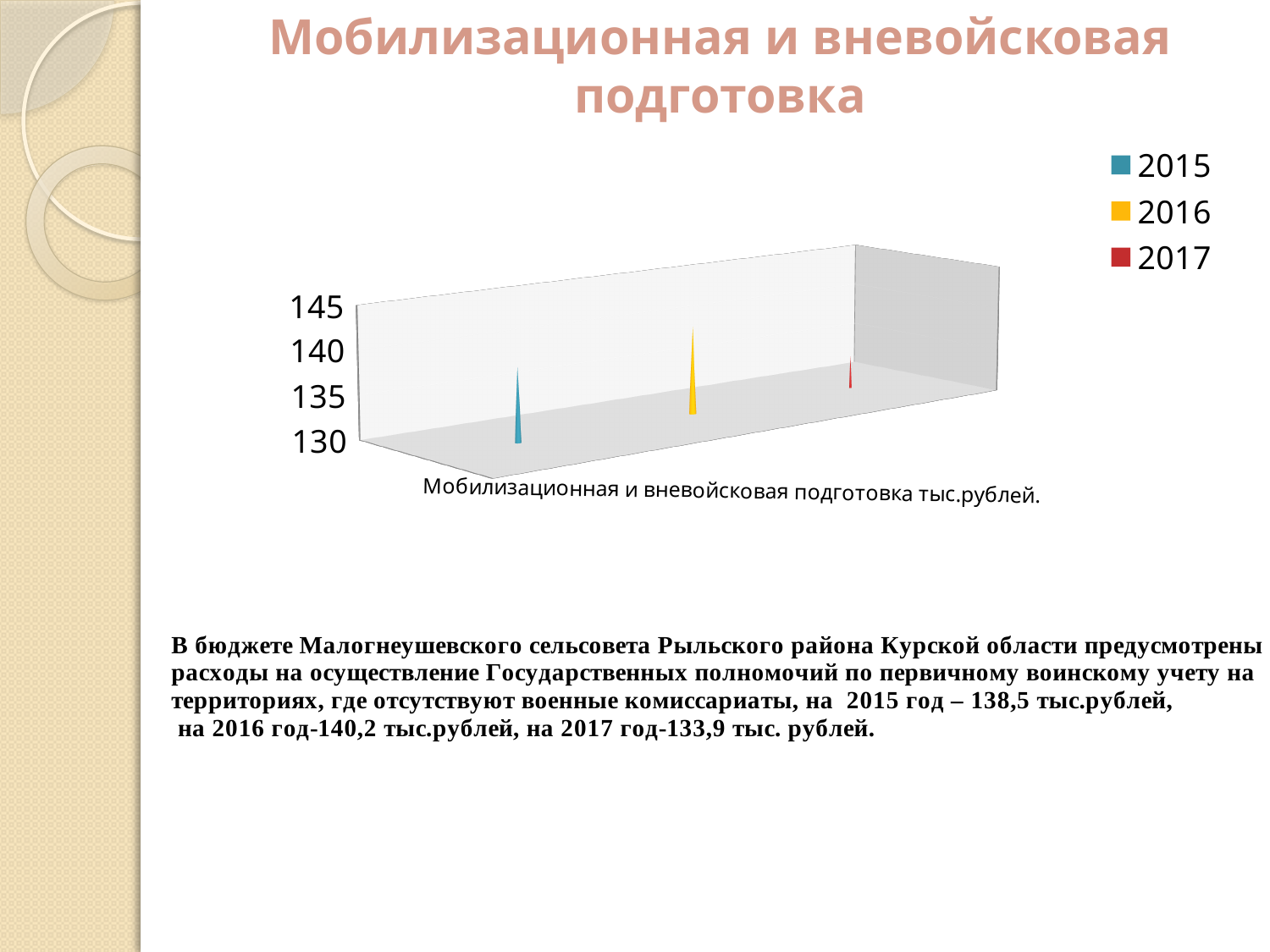
Which is larger, the value for 2015 or the value for 2017? 2015 According to the slide text, what is the amount for 2017 in thousand rubles? 133,9 Do the values rise or fall from 2016 to 2017? fall Is the value for 2017 greater or less than 135? less Is the value for 2015 greater or less than 135? greater Is the value for 2016 greater or less than 135? greater Which years are listed in the chart legend? 2015, 2016, 2017 How many series does the chart legend list? 3 According to the slide text, what is the amount for 2015 in thousand rubles? 138,5 What kind of chart is shown on the slide? bar chart Which year has the highest value in the chart? 2016 Which year has the lowest value in the chart? 2017